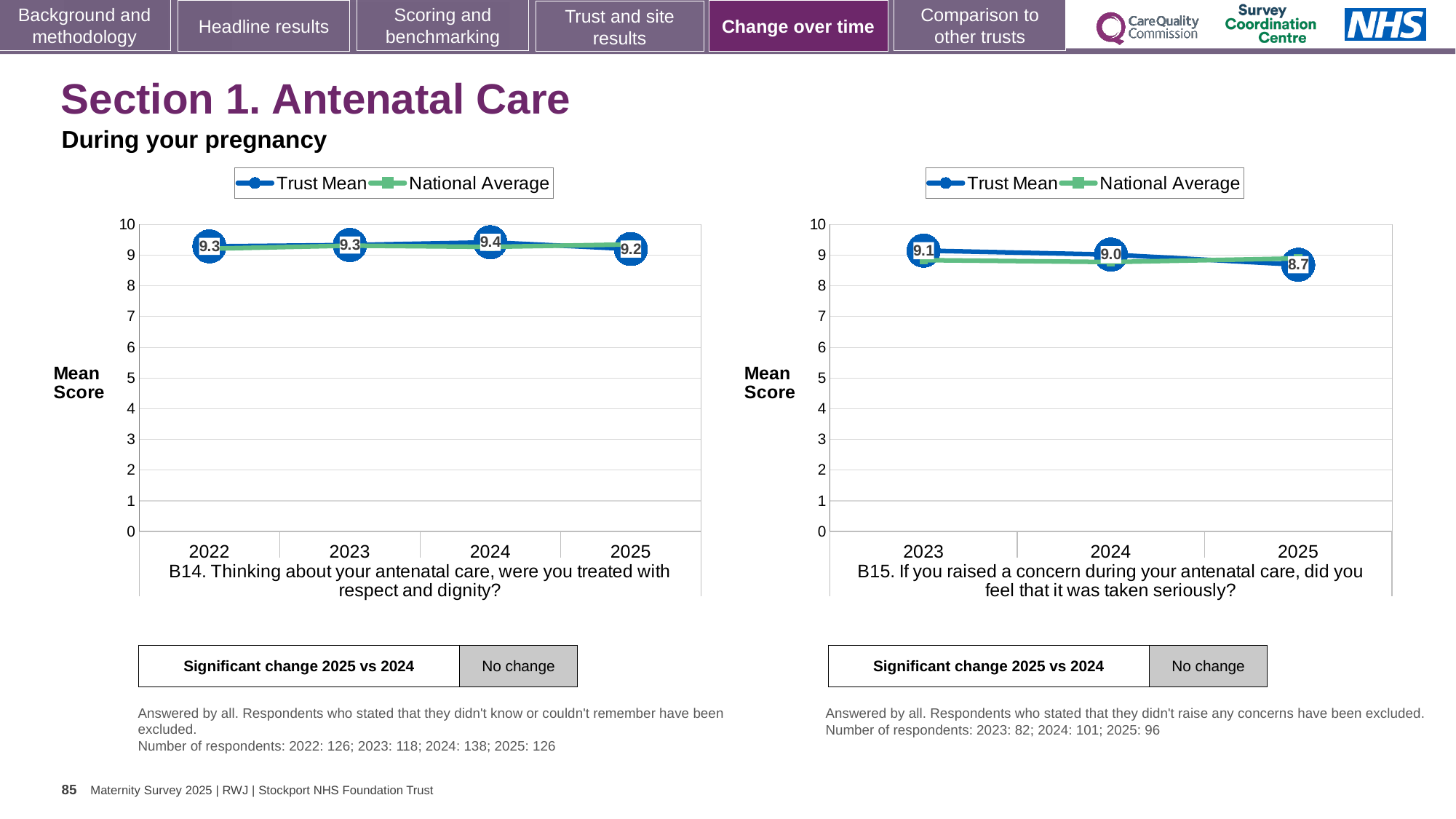
In the B14 chart (left), is the Trust Mean for 2024 or for 2025 larger? 2024 In the B15 chart (right), what is the Trust Mean for 2025? 8.7 In the B14 chart (left), what is the Trust Mean for 2025? 9.2 What kind of chart is the B14 chart (left)? Line chart In the B15 chart (right), what is the difference between the Trust Mean for 2023 and for 2025? 0.4 In the B15 chart (right), does the Trust Mean rise or fall from 2023 to 2025? Fall In the B14 chart (left), which year has the highest Trust Mean? 2024 In the B14 chart (left), what is the Trust Mean for 2024? 9.4 How many series does the legend of the B14 chart (left) list? 2 In the B15 chart (right), which year has the lowest Trust Mean? 2025 How many years are plotted on the x axis of the B15 chart (right)? 3 In the B15 chart (right), what is the Trust Mean for 2023? 9.1